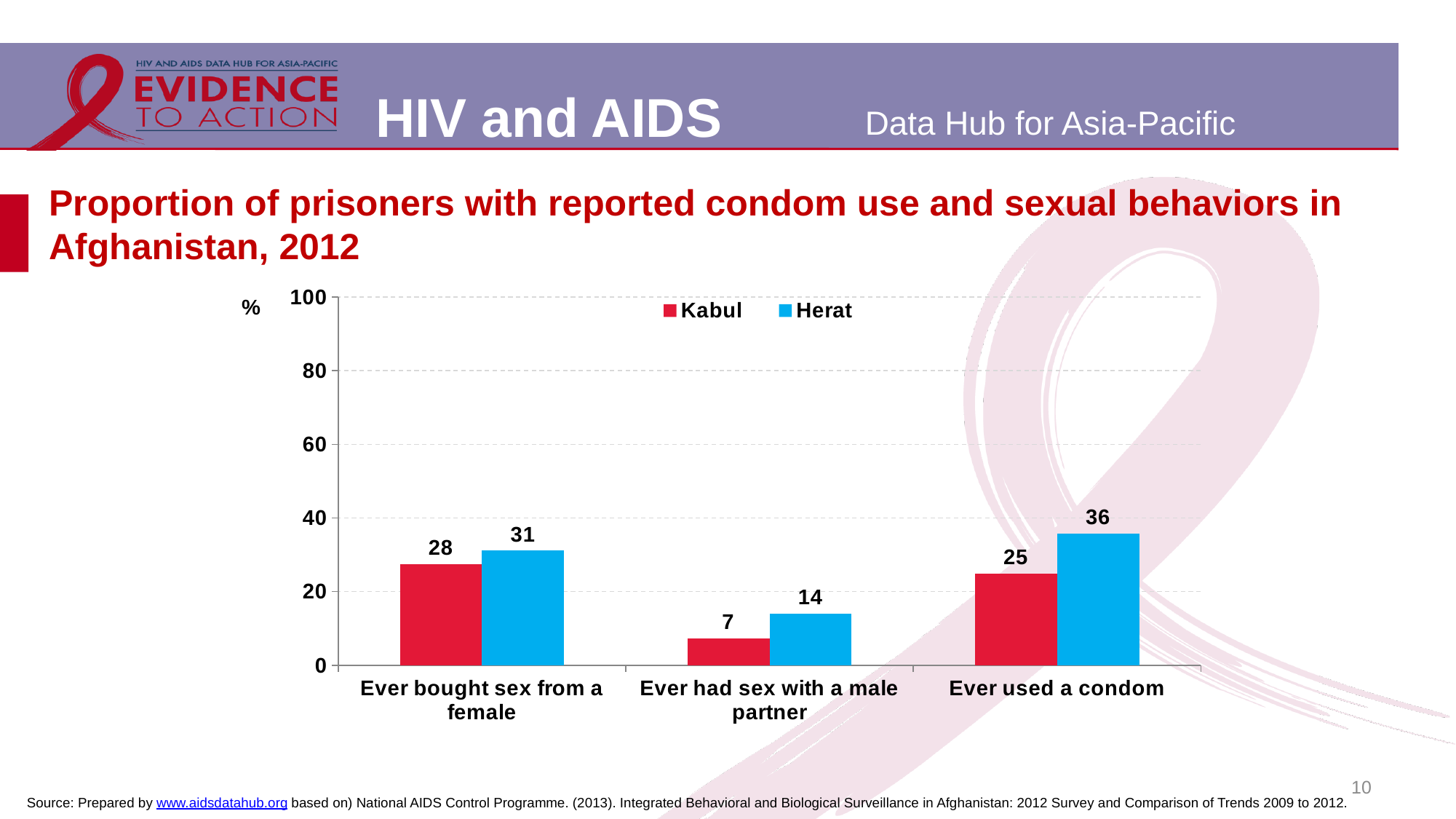
How many categories are shown on the x axis? 3 How many series does the legend list? 2 What is the difference between Herat and Kabul for 'Ever used a condom'? 11 What is the value for Kabul for 'Ever bought sex from a female'? 28 What is the value for Herat for 'Ever used a condom'? 36 Which category has the highest value for Herat? Ever used a condom What is the value for Herat for 'Ever had sex with a male partner'? 14 Which category has the lowest value for Kabul? Ever had sex with a male partner What kind of chart is shown on the slide? Bar chart What is the value for Kabul for 'Ever had sex with a male partner'? 7 Is the value for Herat for 'Ever used a condom' greater or less than 40? less Which is larger for 'Ever bought sex from a female', Kabul or Herat? Herat